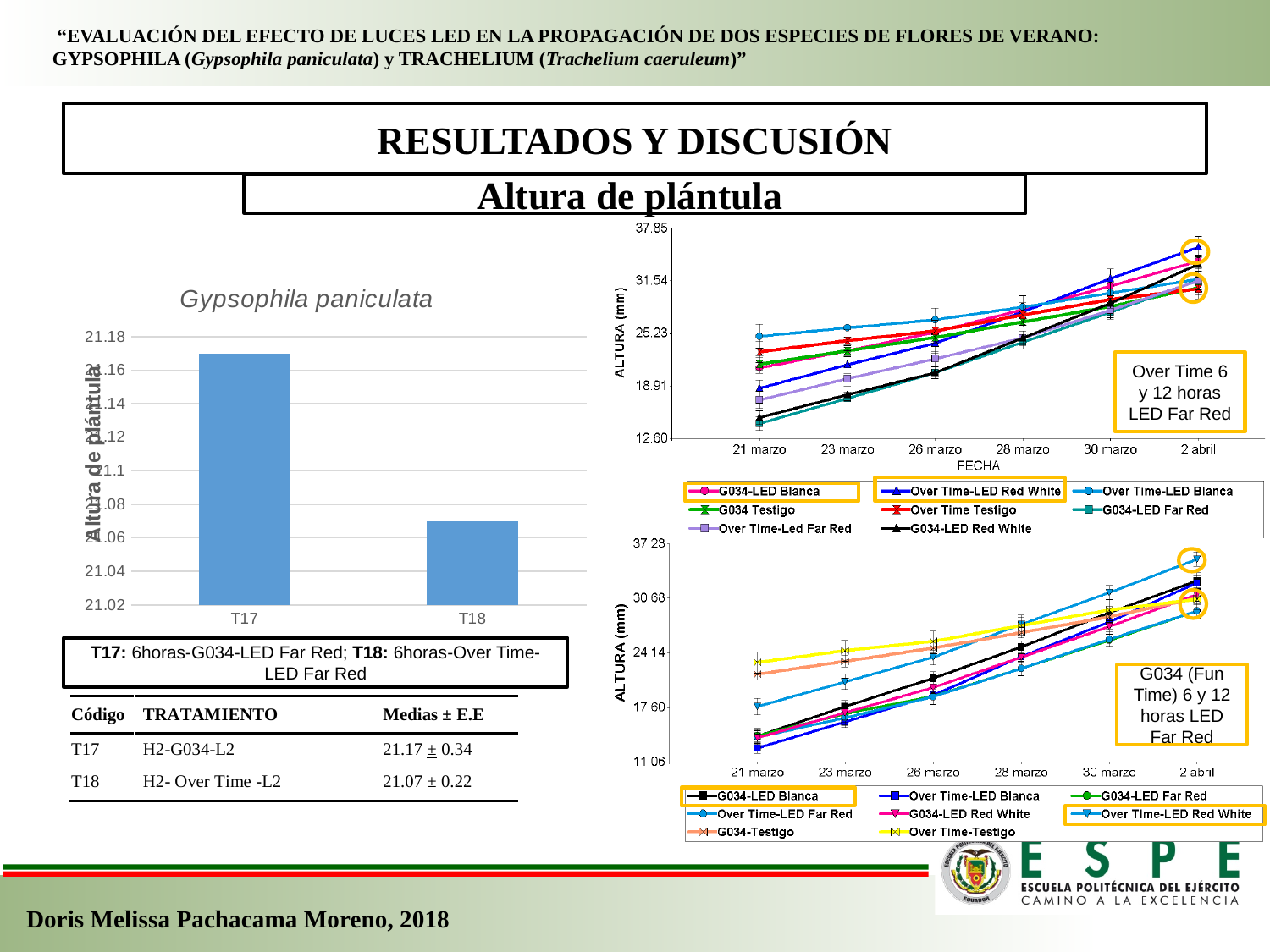
How many categories does the Gypsophila paniculata bar chart show? 2 How many dates are shown on the x axis of the top line chart on the right? 6 What kind of chart is the top chart on the right side of the slide? line chart What kind of chart is the Gypsophila paniculata chart on the left? bar chart In the Gypsophila paniculata bar chart, which category has the taller bar, T17 or T18? T17 In the Gypsophila paniculata bar chart, is the value for T18 greater or less than 21.1? less What is the y-axis label of the top line chart on the right? ALTURA (mm) In the bottom line chart on the right, do the values rise or fall from 21 marzo to 2 abril? rise In the Gypsophila paniculata bar chart, is the value for T17 greater or less than 21.1? greater In the Gypsophila paniculata bar chart, which category has the lowest value? T18 How many series does the legend of the top line chart on the right list? 8 How many series does the legend of the bottom line chart on the right list? 8